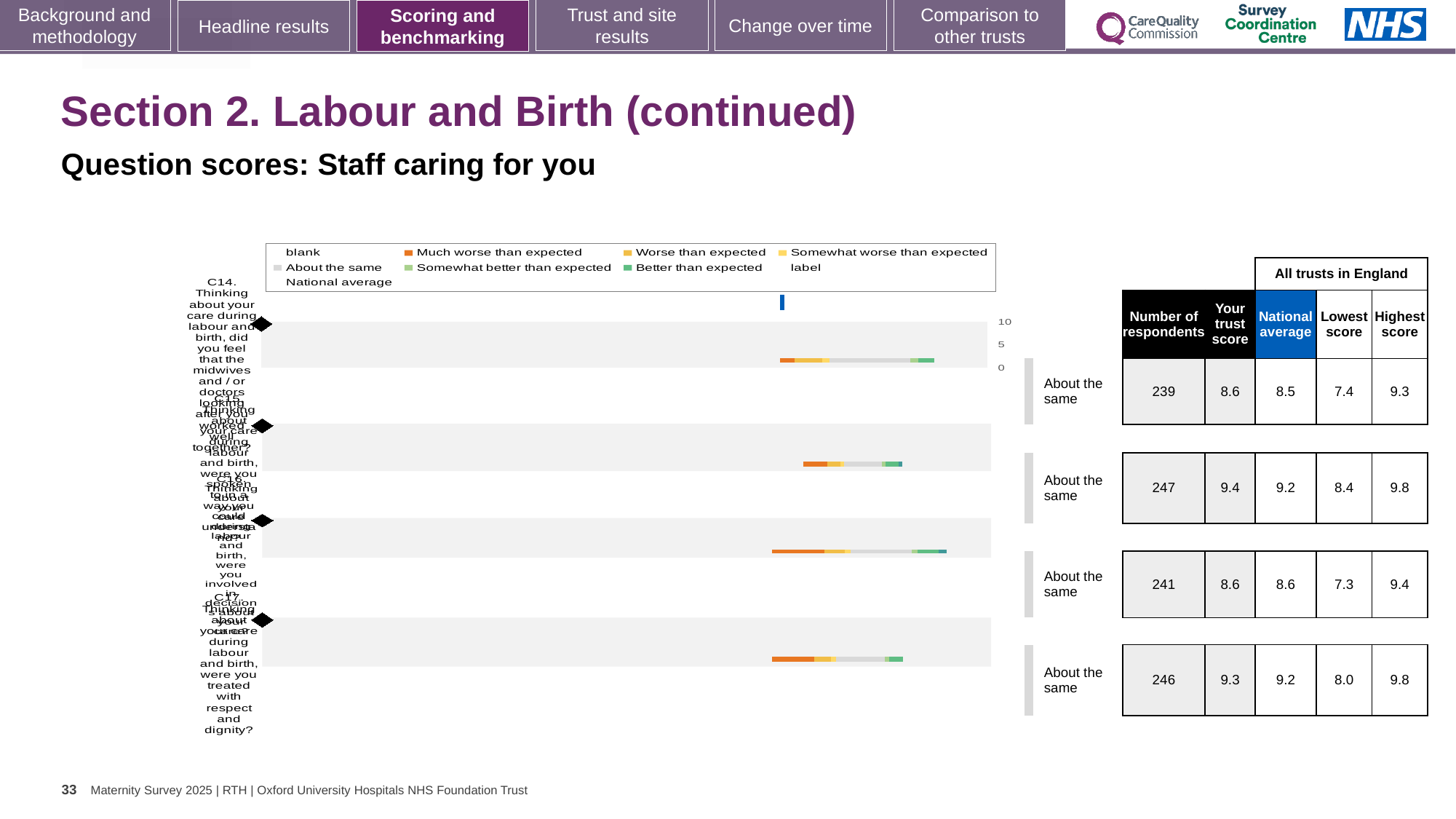
What is the 'Your trust score' for the first row (C14) in the table beside the chart? 8.6 For the first row, what is the difference between the Highest score and the Lowest score? 1.9 What colour does the legend use for 'Much worse than expected'? orange What kind of chart is shown on the slide? bar chart How many question rows (bars) are plotted in the chart? 4 What is the National average for the second row in the table beside the chart? 9.2 Which row has the lowest 'Lowest score' in the table beside the chart? the third row (7.3) What benchmark label is shown for every row of the chart? About the same What is the number of respondents for the third row in the table beside the chart? 241 What is the maximum value shown on the chart's score axis? 10 Which has more respondents, the second row (247) or the fourth row (246)? the second row Which row has the highest 'Your trust score' in the table beside the chart? the second row (9.4)